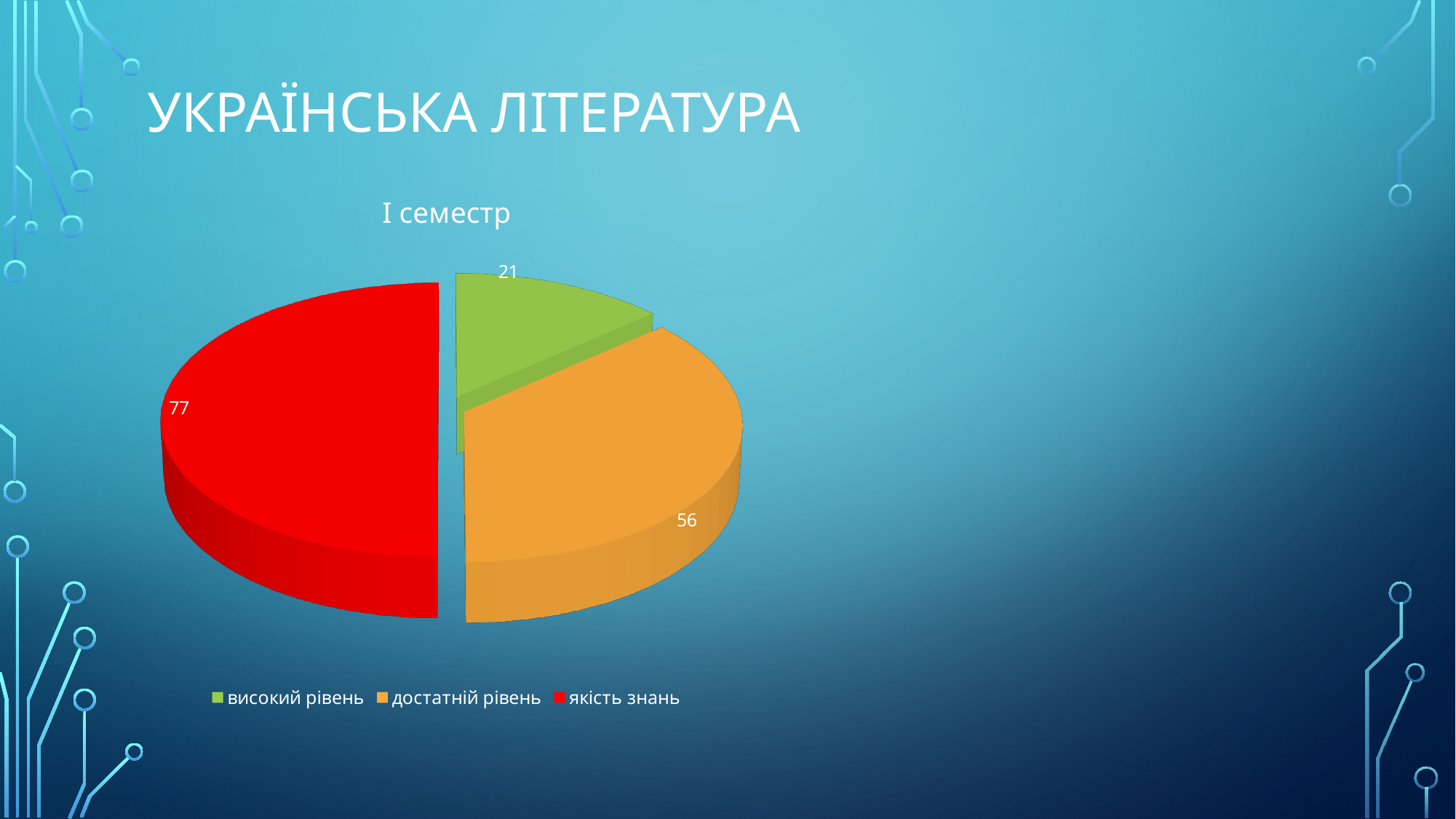
What is the difference between the values for якість знань and достатній рівень? 21 What is the title of the chart? І семестр What is the value for високий рівень? 21 What kind of chart is shown on the slide? pie chart Which category has the smallest slice? високий рівень Which category has the largest slice? якість знань Which is larger, the value for достатній рівень or the value for високий рівень? достатній рівень What is the value for достатній рівень? 56 What is the value for якість знань? 77 What share of the pie does the якість знань slice represent? 50% How many slices does the pie chart have? 3 What is the difference between the values for достатній рівень and високий рівень? 35